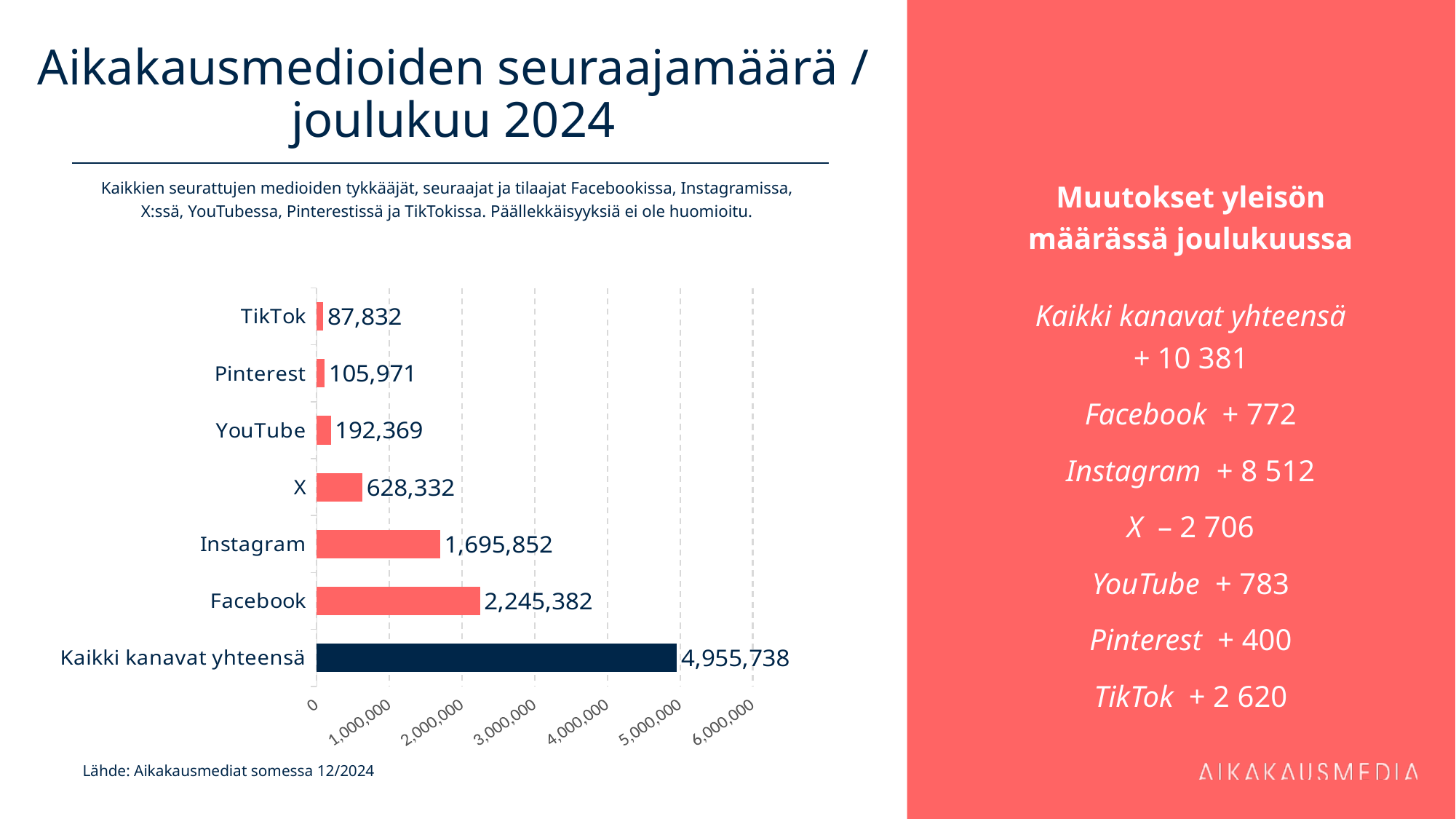
How many categories are shown in the chart? 7 What is the value for Kaikki kanavat yhteensä? 4,955,738 What is the value for X? 628,332 What is the value for Facebook? 2,245,382 Which category has the lowest value? TikTok What is the difference between the values for Facebook and Instagram? 549,530 Which is larger, the value for YouTube or the value for Pinterest? YouTube What is the value for Instagram? 1,695,852 Which category has the highest value? Kaikki kanavat yhteensä What is the value for TikTok? 87,832 What kind of chart is shown on the slide? Bar chart What is the difference between the values for Pinterest and TikTok? 18,139